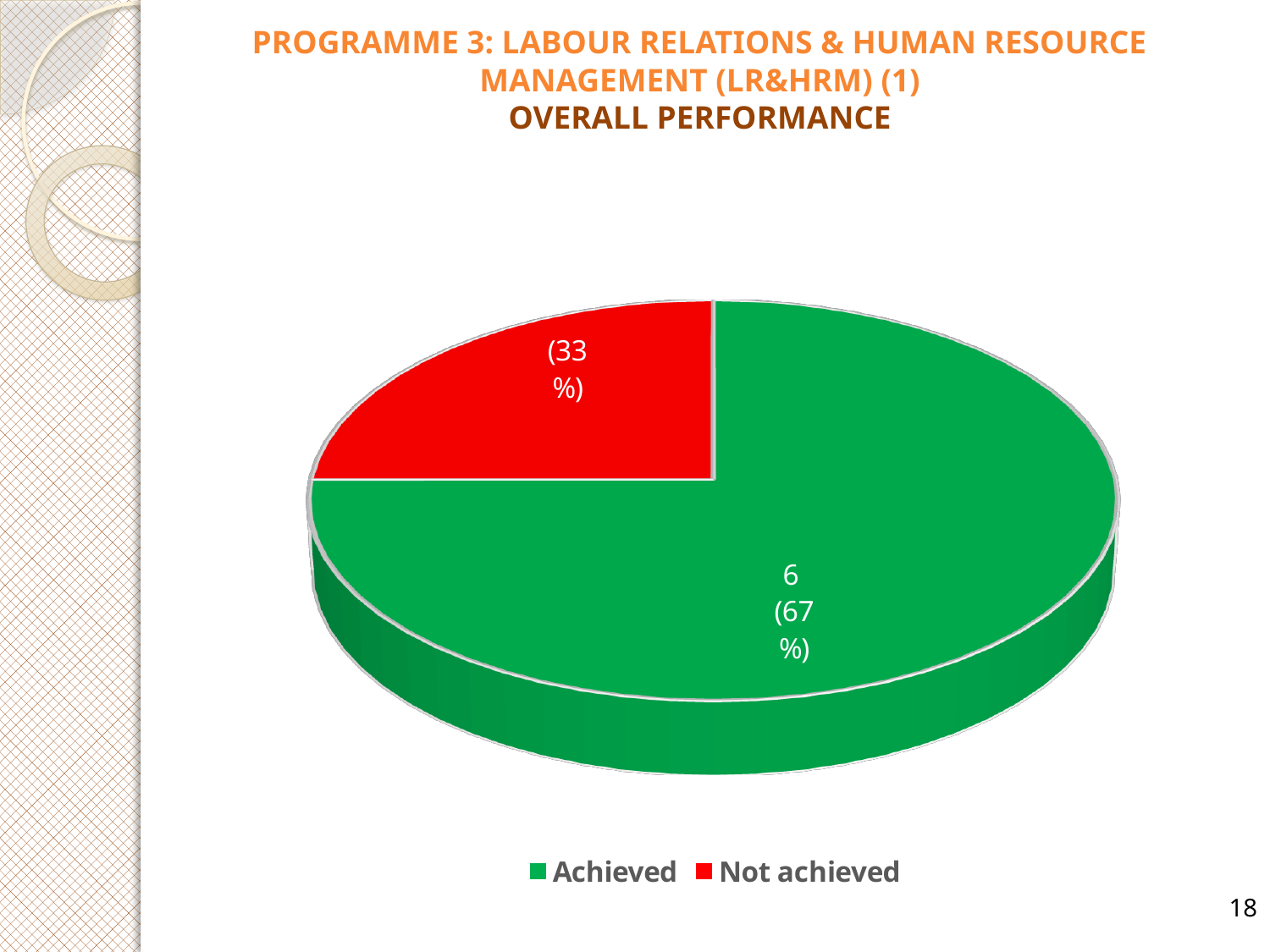
What is the count shown for the Achieved slice? 6 What colour is the Achieved slice? green Which slice is the smallest? Not achieved Which slice is larger, Achieved or Not achieved? Achieved How many entries does the legend list? 2 What percentage of the pie is the Not achieved slice? 33% Which slice is the largest? Achieved What percentage of the pie is the Achieved slice? 67% How many slices does the pie chart have? 2 What colour is the Not achieved slice? red What is the difference in percentage points between the Achieved and Not achieved slices? 34 What kind of chart is shown on the slide? pie chart